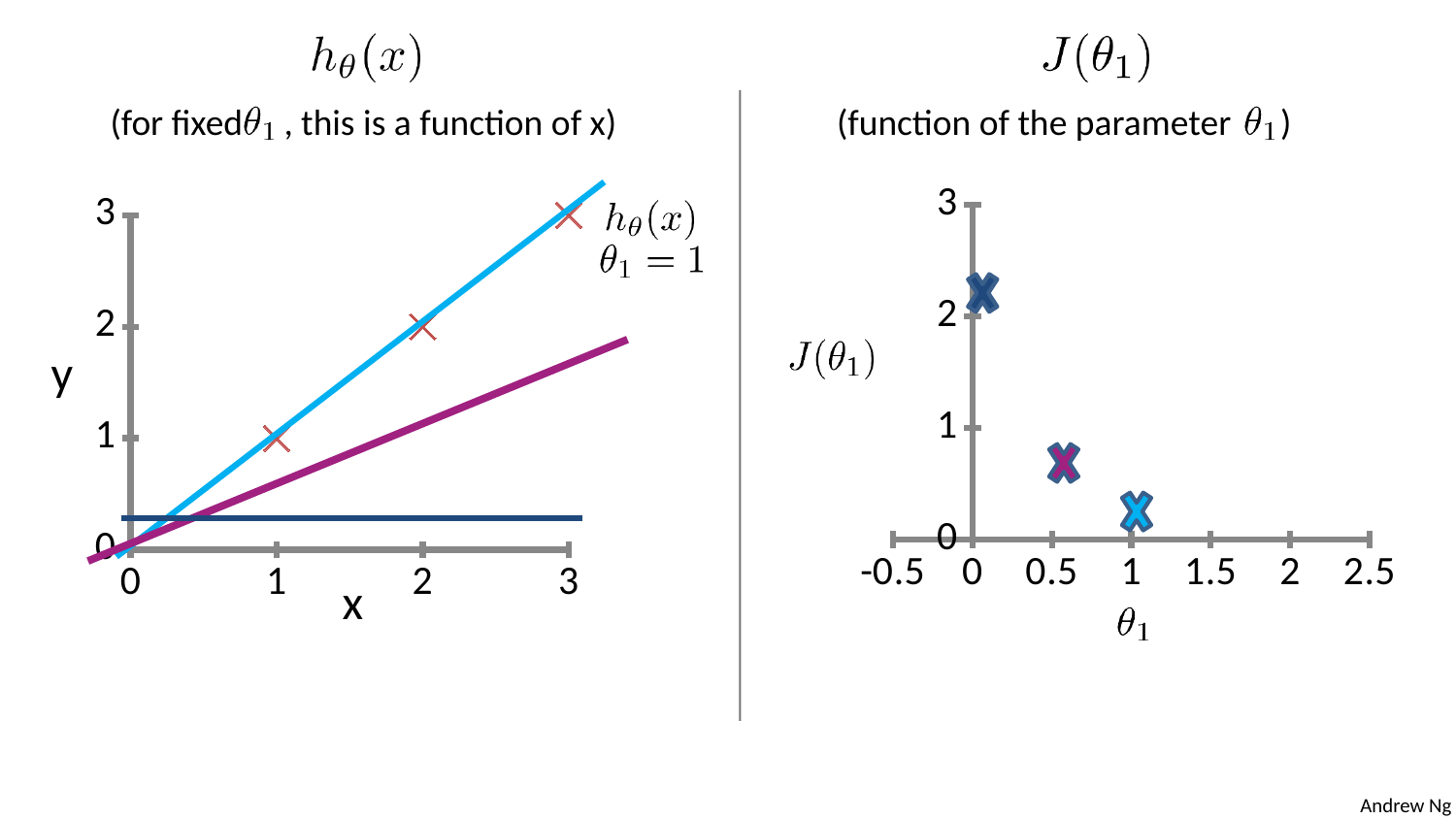
On the right chart J(θ1), do the plotted values rise or fall as θ1 increases from 0 to 1? fall On the right chart J(θ1), is the value at θ1 = 1 greater or less than 1? less On the left chart h_θ(x), what is the y value of the data point at x = 3? 3 On the right chart J(θ1), at which θ1 value is the plotted J(θ1) highest? 0 On the right chart J(θ1), how many points are plotted? 3 On the right chart J(θ1), is the value at θ1 = 0 greater or less than 2? greater On the left chart h_θ(x), how many red data points are plotted? 3 On the left chart h_θ(x), which line passes through all three red data points? the light blue line (θ1 = 1) On the left chart h_θ(x), what is the y value of the data point at x = 2? 2 On the left chart h_θ(x), how many lines are drawn through the plot area? 3 On the right chart J(θ1), which has the larger J(θ1) value: the point at θ1 = 0.5 or the point at θ1 = 1? θ1 = 0.5 What kind of chart is the left chart titled h_θ(x)? line chart